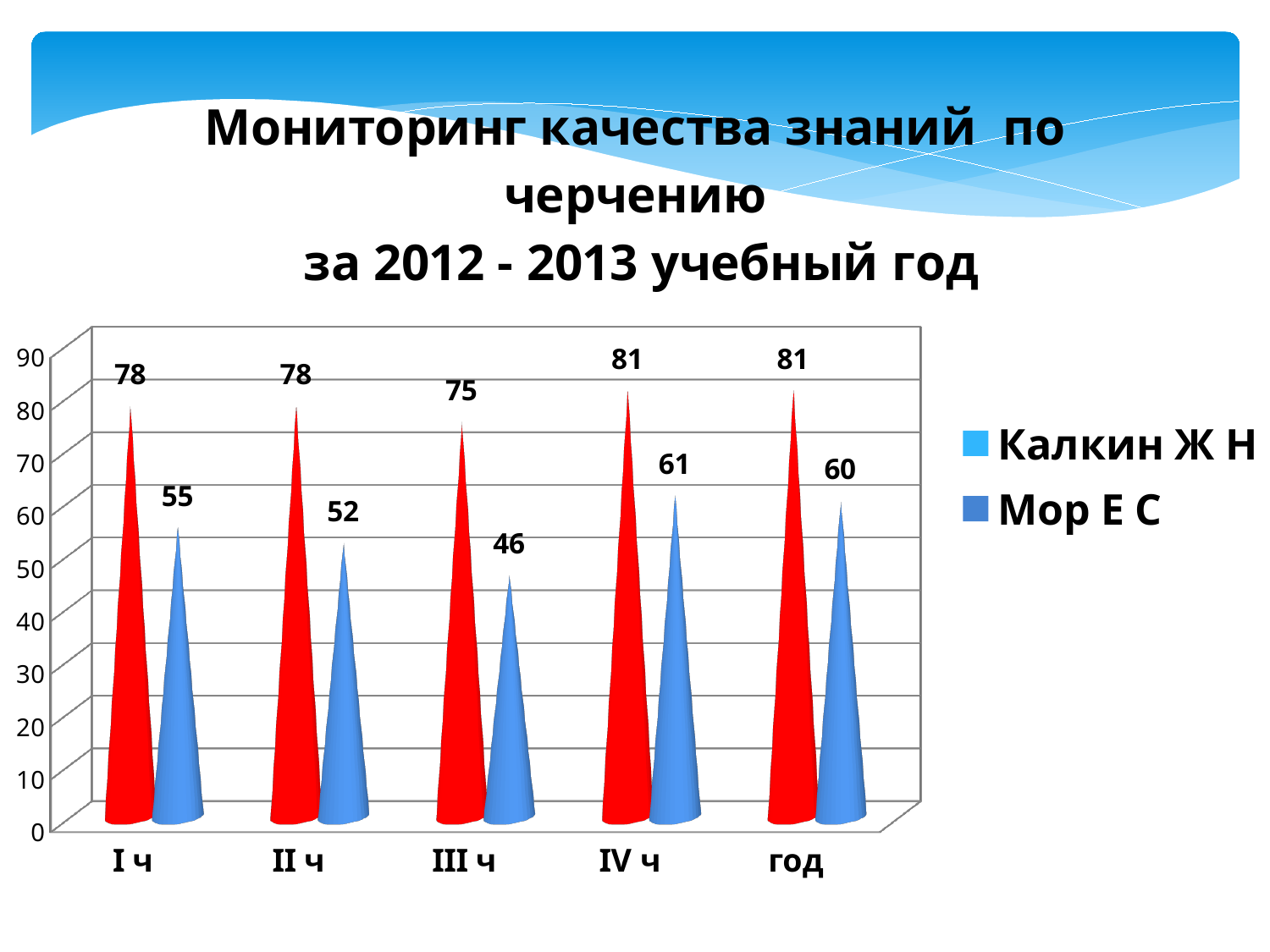
In which category is the value for Мор Е С lowest? III ч What is the value for Калкин Ж Н in I ч? 78 What is the value for Мор Е С in III ч? 46 Which series has the larger value in IV ч, Калкин Ж Н or Мор Е С? Калкин Ж Н How many categories are shown on the x axis? 5 What kind of chart is shown on the slide? bar chart What is the difference between Калкин Ж Н and Мор Е С in II ч? 26 What is the value for Мор Е С for год? 60 What are the two series named in the legend? Калкин Ж Н and Мор Е С In which category is the value for Мор Е С highest? IV ч How many series does the legend list? 2 What is the difference between Калкин Ж Н and Мор Е С for год? 21